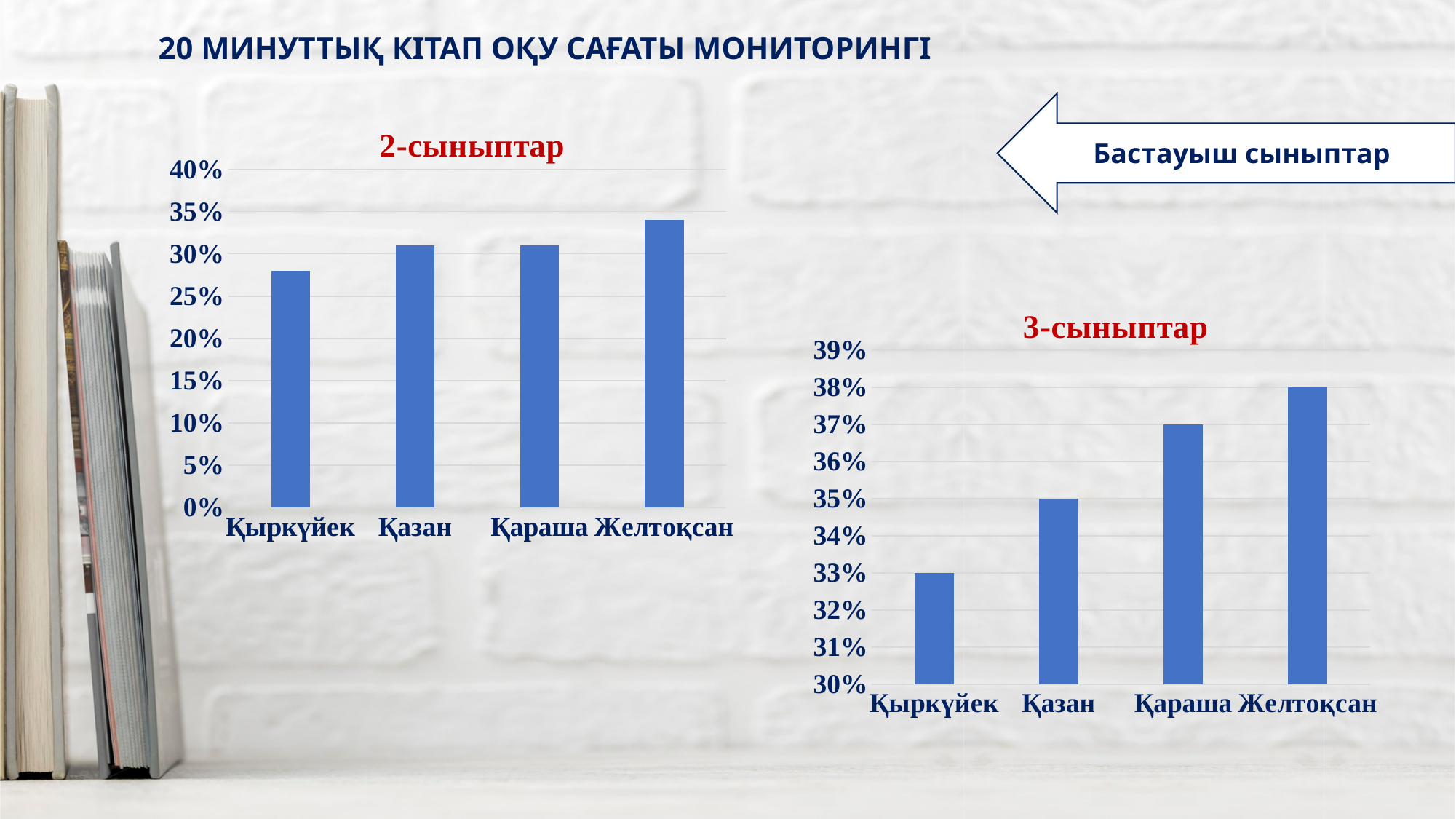
In the 3-сыныптар chart, what is the value for Қараша? 37% What kind of chart is the 3-сыныптар chart? bar chart In the 3-сыныптар chart, what is the value for Желтоқсан? 38% In the 3-сыныптар chart, what is the value for Қыркүйек? 33% In the 3-сыныптар chart, what is the difference between the values for Желтоқсан and Қыркүйек? 5 percentage points How many categories are shown in the 2-сыныптар chart? 4 In the 2-сыныптар chart, which month has the lowest value? Қыркүйек In the 3-сыныптар chart, what is the value for Қазан? 35% In the 2-сыныптар chart, which month has the highest value? Желтоқсан In the 3-сыныптар chart, do the values rise or fall from Қыркүйек to Желтоқсан? rise In the 2-сыныптар chart, is the value for Желтоқсан greater or less than 30%? greater In the 2-сыныптар chart, is the value for Қыркүйек greater or less than 30%? less